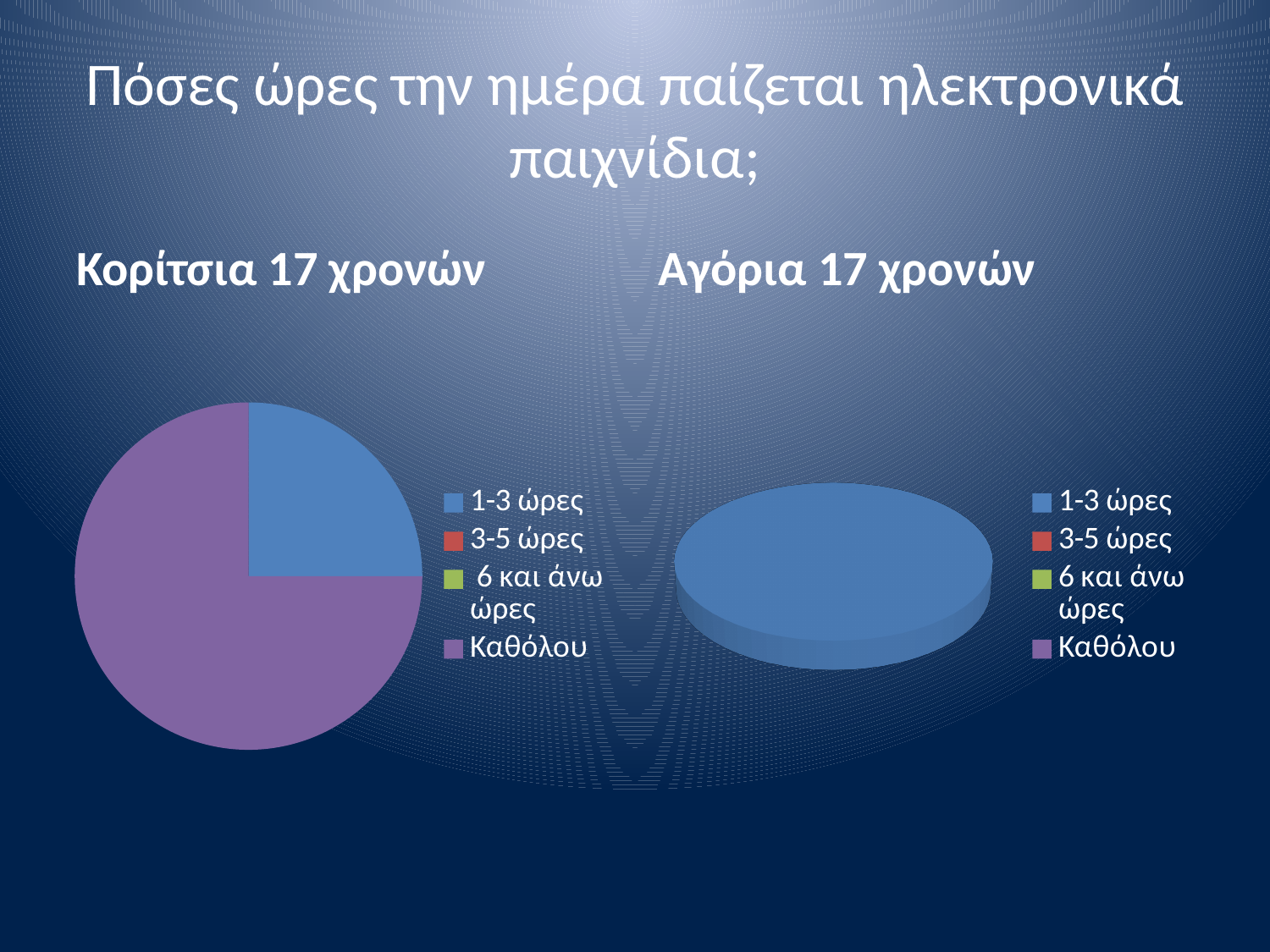
What colour represents 'Καθόλου' in the legend of the left chart 'Κορίτσια 17 χρονών'? purple In the left chart 'Κορίτσια 17 χρονών', which category has the largest slice? Καθόλου In the right chart 'Αγόρια 17 χρονών', how many slices are visible in the pie? 1 How many entries does the legend of the left chart 'Κορίτσια 17 χρονών' list? 4 What kind of chart is the left chart titled 'Κορίτσια 17 χρονών'? pie chart In the left chart 'Κορίτσια 17 χρονών', how many slices are visible in the pie? 2 What is the title of the chart on the right side of the slide? Αγόρια 17 χρονών In the left chart 'Κορίτσια 17 χρονών', which is larger: the slice for '1-3 ώρες' or the slice for 'Καθόλου'? Καθόλου What kind of chart is the right chart titled 'Αγόρια 17 χρονών'? pie chart How many entries does the legend of the right chart 'Αγόρια 17 χρονών' list? 4 In the right chart 'Αγόρια 17 χρονών', which category takes up the whole pie? 1-3 ώρες